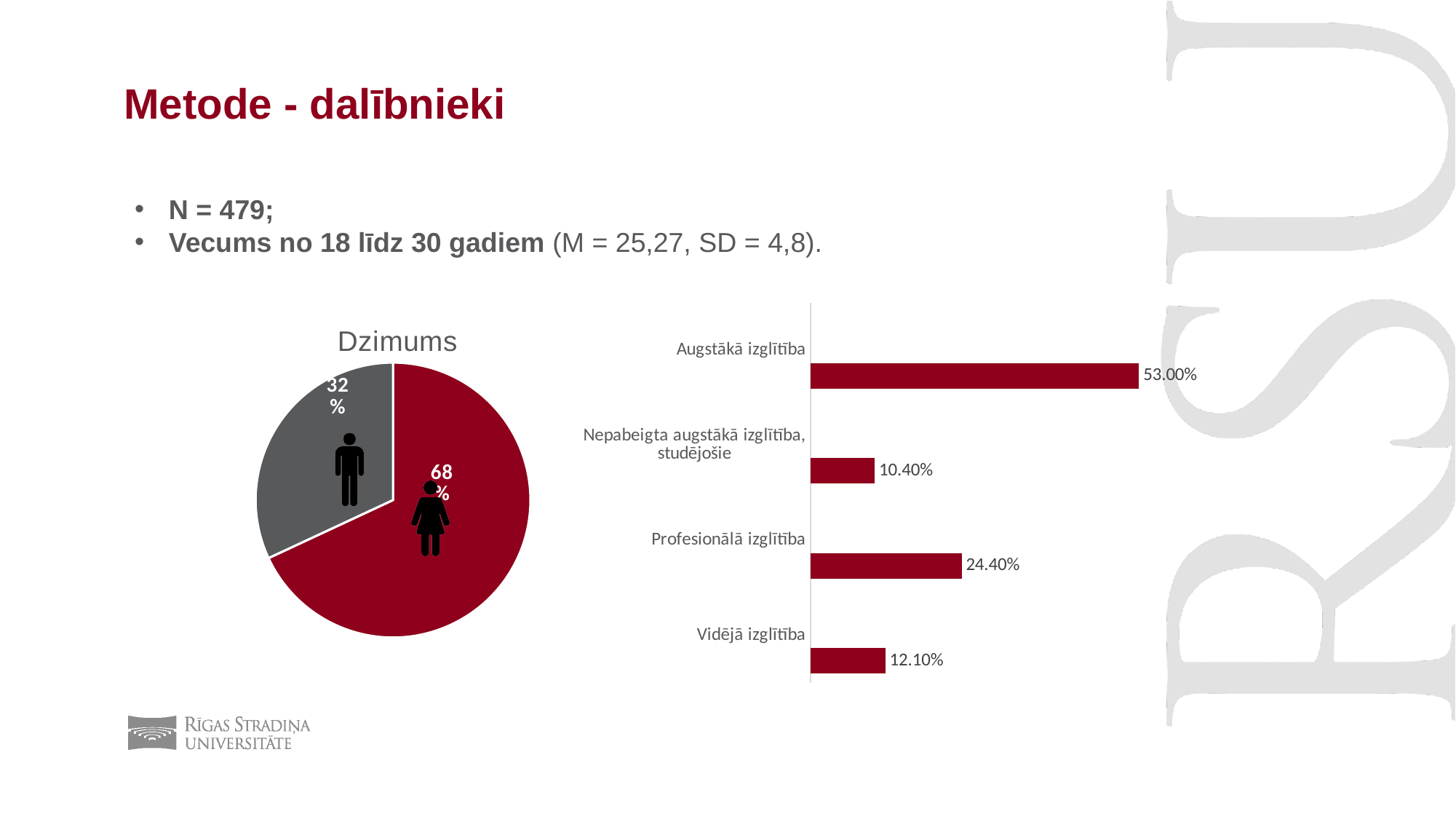
What kind of chart is the chart titled "Dzimums"? pie chart In the bar chart on the right, how many categories are shown? 4 In the pie chart titled "Dzimums", what share does the larger (dark red) slice represent? 68% In the bar chart on the right, what is the difference between the values for Augstākā izglītība and Profesionālā izglītība? 28.60% In the bar chart on the right, which category has the lowest value? Nepabeigta augstākā izglītība, studējošie In the pie chart titled "Dzimums", what share does the grey slice represent? 32% In the bar chart on the right, what is the value for Profesionālā izglītība? 24.40% In the bar chart on the right, what is the value for Vidējā izglītība? 12.10% In the bar chart on the right, which category has the highest value? Augstākā izglītība In the bar chart on the right, what is the value for Augstākā izglītība? 53.00% How many slices does the pie chart titled "Dzimums" have? 2 In the bar chart on the right, what is the value for Nepabeigta augstākā izglītība, studējošie? 10.40%